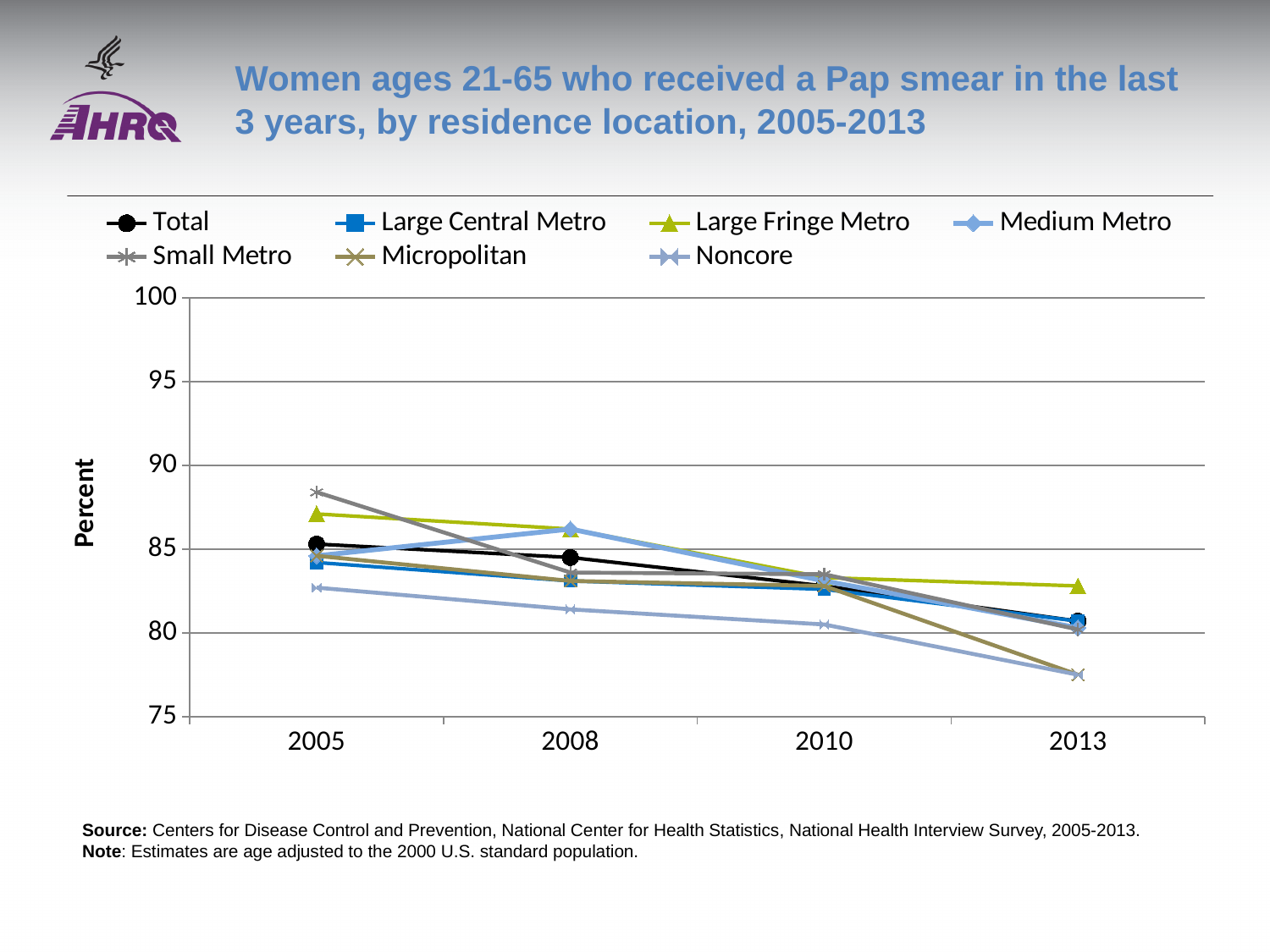
Does the Total series rise or fall from 2005 to 2013? fall How many series does the legend list? 7 Which series has the lowest value in 2005? Noncore Which series has the highest value in 2013? Large Fringe Metro What kind of chart is shown on the slide? line chart Is the value for Noncore in 2013 greater or less than 80? less Does the Noncore series rise or fall from 2005 to 2013? fall How many years are plotted along the x axis? 4 Which series has the highest value in 2005? Small Metro What is the label on the y axis? Percent Is the value for Small Metro in 2005 greater or less than 85? greater Is the value for Large Fringe Metro in 2013 greater or less than 80? greater